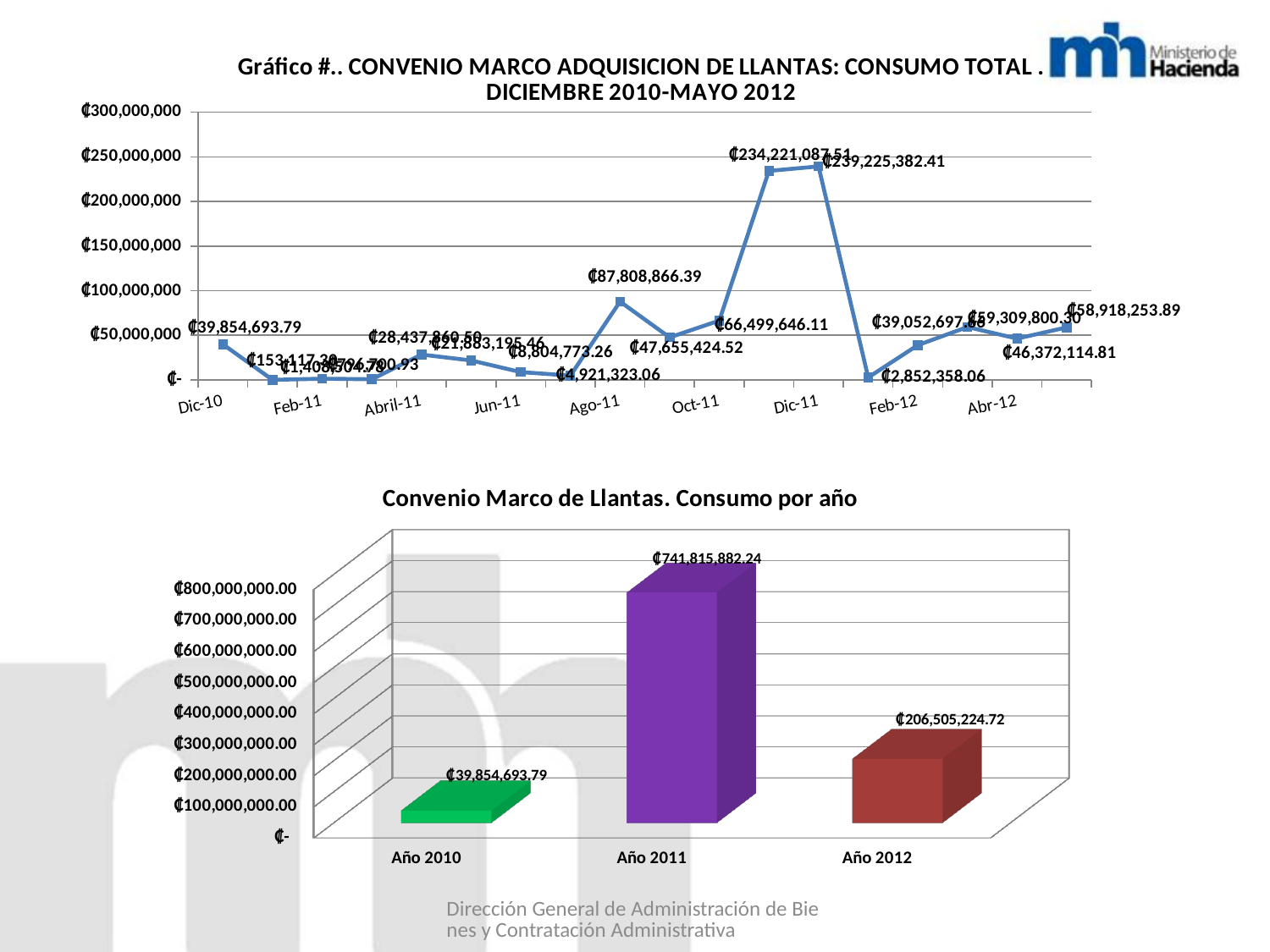
In the bottom chart 'Consumo por año', what is the value for Año 2011? ₡741,815,882.24 In the top chart 'CONSUMO TOTAL', is the value for Oct-11 greater or less than ₡100,000,000? less In the bottom chart 'Consumo por año', which year has the highest consumption? Año 2011 In the bottom chart 'Consumo por año', what is the difference between the values for Año 2011 and Año 2012? ₡535,310,657.52 How many years are shown in the bottom chart 'Consumo por año'? 3 What kind of chart is the top chart, 'CONVENIO MARCO ADQUISICION DE LLANTAS: CONSUMO TOTAL'? Line chart In the top chart 'CONSUMO TOTAL', what is the value for Dic-10? ₡39,854,693.79 In the bottom chart 'Consumo por año', which year has the lowest consumption? Año 2010 In the bottom chart 'Consumo por año', what is the value for Año 2012? ₡206,505,224.72 In the top chart 'CONSUMO TOTAL', what is the value for Ago-11? ₡87,808,866.39 In the top chart 'CONSUMO TOTAL', which month has the highest value? Dic-11 What kind of chart is the bottom chart, 'Convenio Marco de Llantas. Consumo por año'? Bar chart